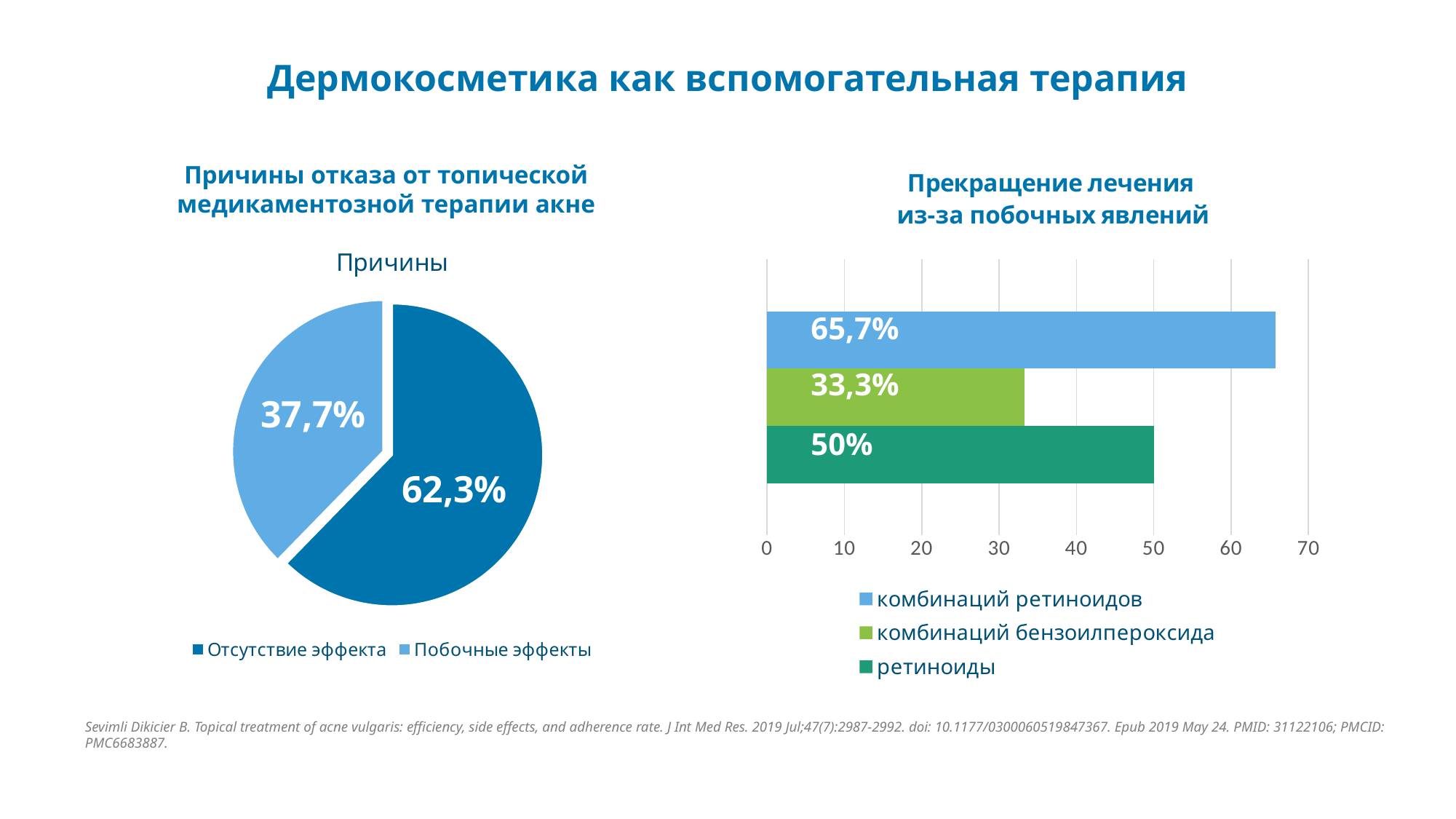
На диаграмме «Прекращение лечения из-за побочных явлений» какое значение у «комбинаций бензоилпероксида»? 33,3% На диаграмме «Прекращение лечения из-за побочных явлений» какое значение у «комбинаций ретиноидов»? 65,7% На круговой диаграмме «Причины» на сколько процентных пунктов доля «Отсутствие эффекта» больше доли «Побочные эффекты»? 24,6 На диаграмме «Прекращение лечения из-за побочных явлений» у какой категории наименьшее значение? комбинаций бензоилпероксида Сколько элементов перечислено в легенде диаграммы «Прекращение лечения из-за побочных явлений»? 3 На диаграмме «Прекращение лечения из-за побочных явлений» на сколько процентных пунктов значение «комбинаций ретиноидов» больше значения «ретиноиды»? 15,7 На круговой диаграмме «Причины» какая доля приходится на «Отсутствие эффекта»? 62,3% На круговой диаграмме «Причины» какая категория занимает наибольшую долю? Отсутствие эффекта На диаграмме «Прекращение лечения из-за побочных явлений» какое значение у «ретиноиды»? 50% На круговой диаграмме «Причины» какая доля приходится на «Побочные эффекты»? 37,7% На диаграмме «Прекращение лечения из-за побочных явлений» что больше: значение для «ретиноиды» или для «комбинаций бензоилпероксида»? ретиноиды Какого типа диаграмма слева под заголовком «Причины»? Круговая диаграмма